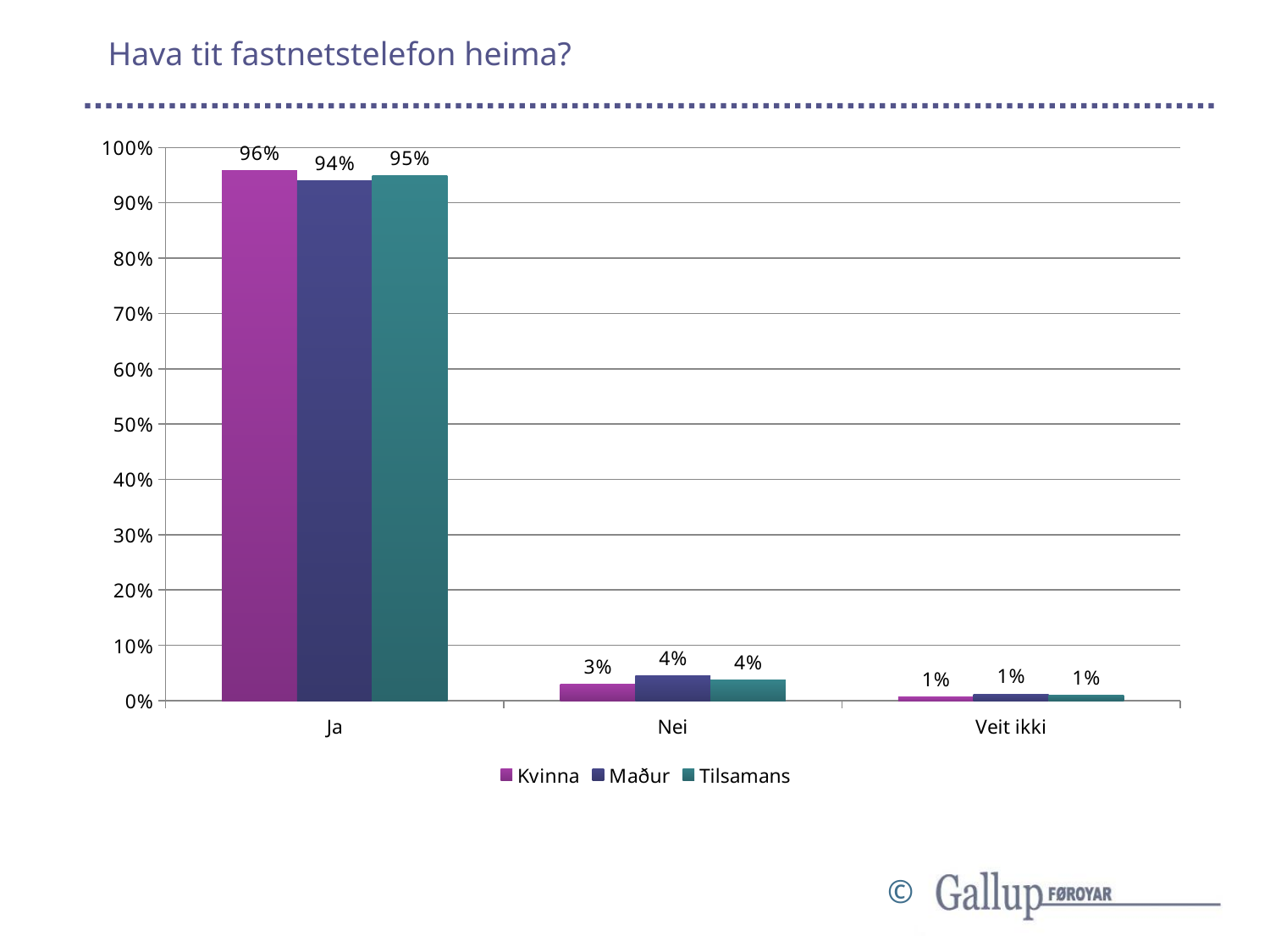
Which is larger in the Ja category, the value for Kvinna or the value for Maður? Kvinna What is the value for Maður in the Nei category? 4% What is the value for Kvinna in the Ja category? 96% How many categories are shown on the x axis? 3 What is the value for Tilsamans in the Veit ikki category? 1% Which category has the highest value for Tilsamans? Ja How many series does the legend list? 3 Is the value for Tilsamans in the Ja category greater or less than 90%? greater What is the difference between the Kvinna and Maður values in the Ja category? 2% Which category has the lowest value for Kvinna? Veit ikki What kind of chart is shown on the slide? bar chart What is the title of the chart? Hava tit fastnetstelefon heima?